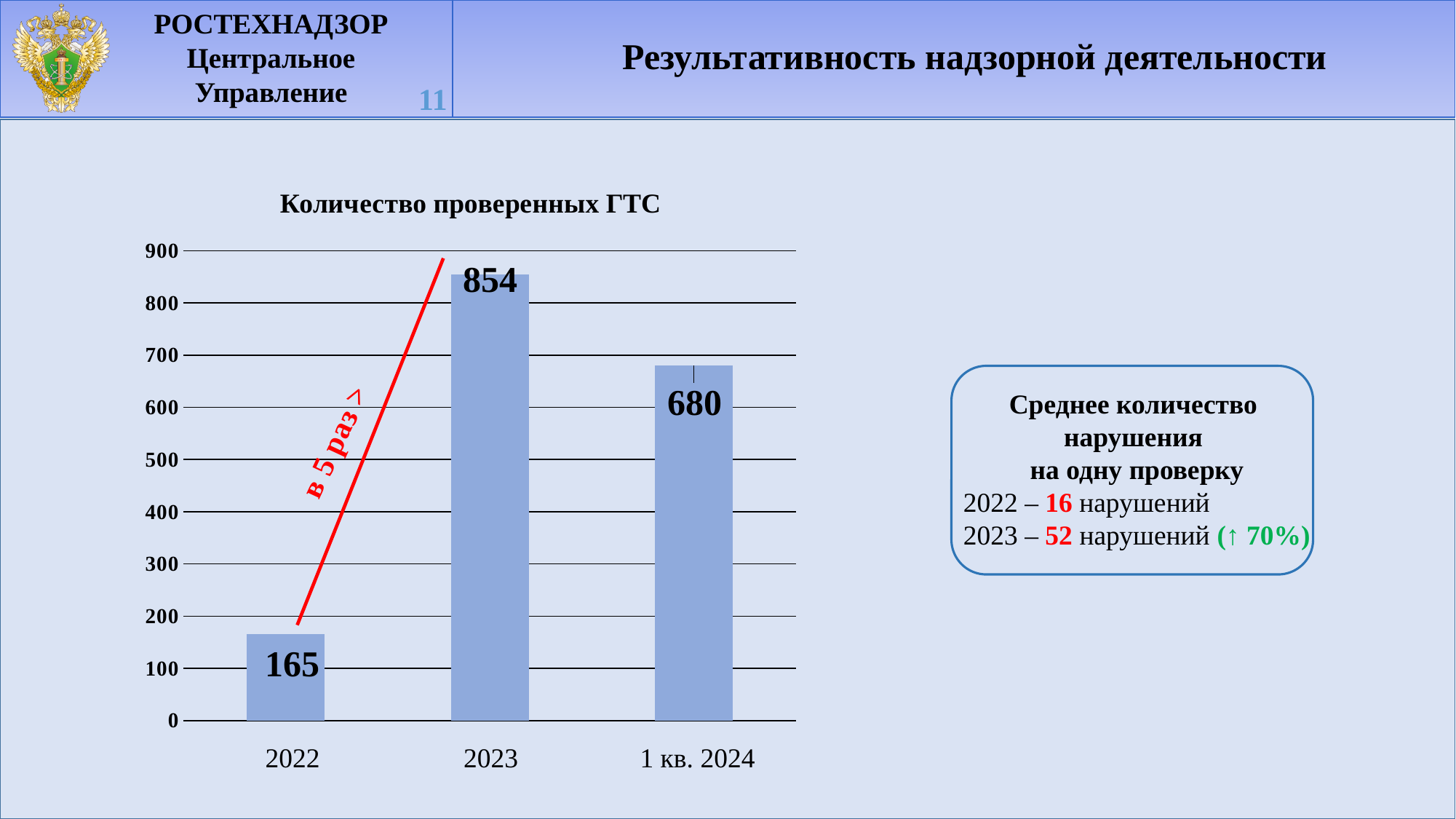
What is the value for 1 кв. 2024 in the chart? 680 Is the value for 1 кв. 2024 greater or less than 600? greater What is the difference between the values for 2023 and 2022? 689 What is the title of the chart? Количество проверенных ГТС What is the difference between the values for 2023 and 1 кв. 2024? 174 What kind of chart is shown on the slide? bar chart What is the value for 2023 in the chart? 854 Which category has the highest value in the chart? 2023 Which category has the lowest value in the chart? 2022 What is the value for 2022 in the chart 'Количество проверенных ГТС'? 165 How many categories are shown on the x axis of the chart? 3 Which is larger, the value for 1 кв. 2024 or the value for 2022? 1 кв. 2024